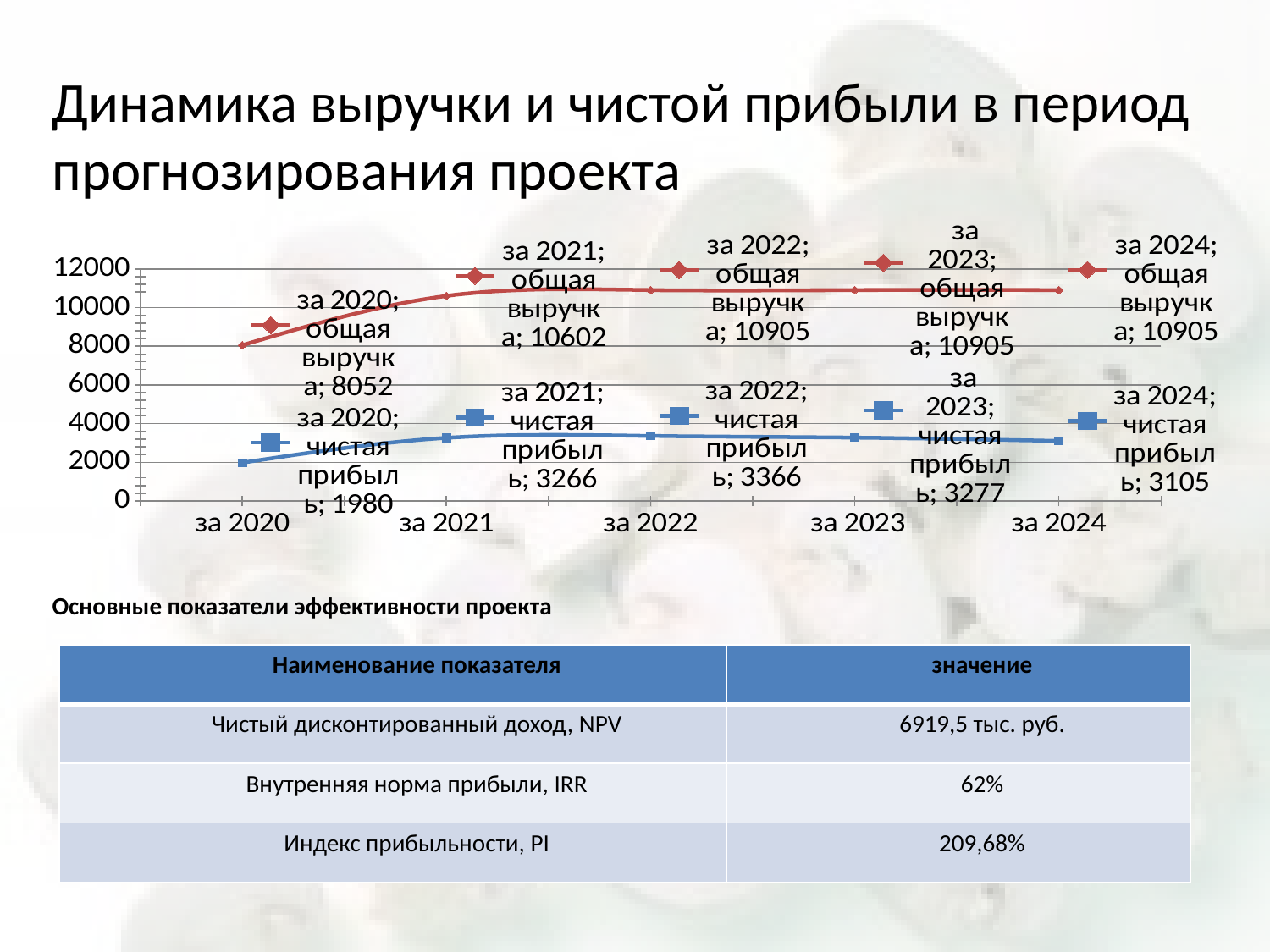
What is the difference between общая выручка for за 2021 and за 2020? 2550 Does общая выручка rise or fall from за 2020 to за 2022? rise How many years are plotted on the x axis of the chart? 5 What is the difference between чистая прибыль for за 2021 and за 2020? 1286 What is the value of чистая прибыль for за 2022? 3366 Which is larger: чистая прибыль for за 2023 or for за 2024? за 2023 What is the value of общая выручка for за 2020? 8052 In which year is чистая прибыль the highest? за 2022 In which year is чистая прибыль the lowest? за 2020 What type of chart is shown on the slide? line chart What is the value of чистая прибыль for за 2024? 3105 What is the value of общая выручка for за 2021? 10602